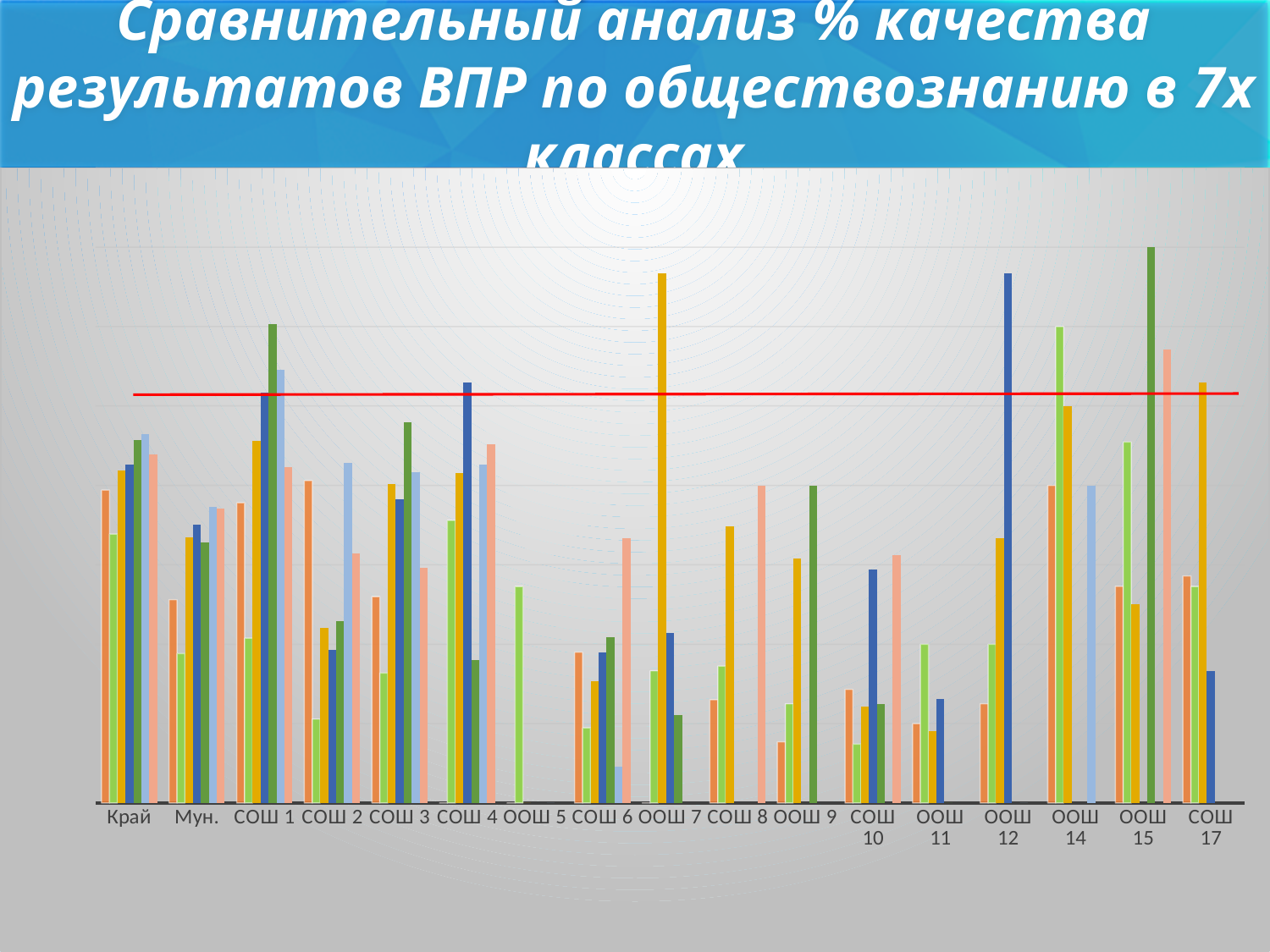
Is the dark green bar for ООШ 15 taller or shorter than the dark green bar for СОШ 1? taller What is the last category on the x axis of the chart? СОШ 17 What kind of chart is shown on the slide? bar chart Is the gold bar for ООШ 7 taller or shorter than the gold bar for СОШ 8? taller What is the first category on the x axis of the chart? Край Which category has only one bar plotted? ООШ 5 How many categories are labelled along the x axis of the chart? 17 Is the dark blue bar for ООШ 12 taller or shorter than the dark blue bar for ООШ 11? taller Which category contains the single tallest bar in the chart? ООШ 15